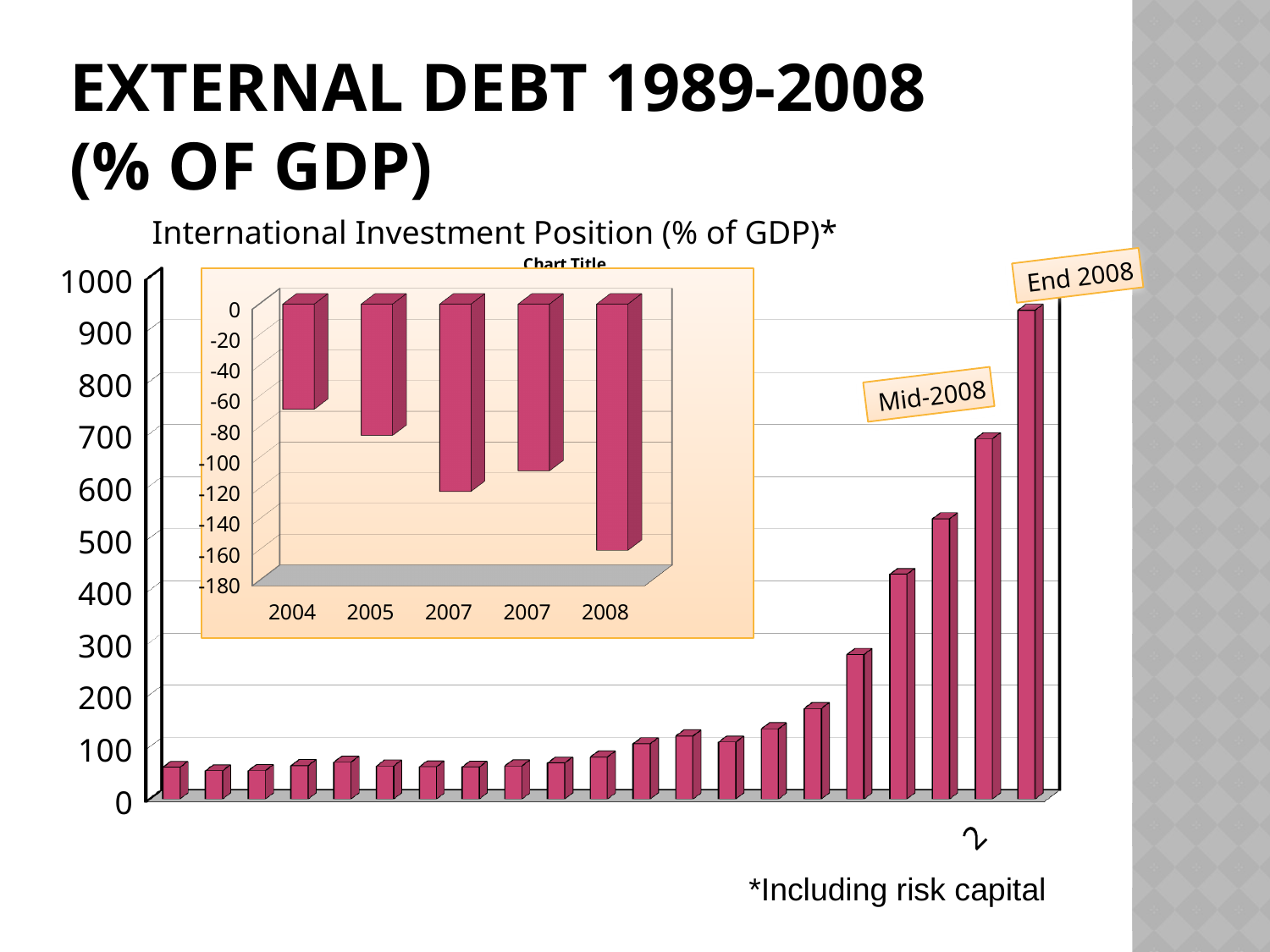
In the inset chart 'International Investment Position (% of GDP)*', is the value for 2004 greater or less than -40? less What kind of chart is the large chart on the slide? bar chart In the inset chart 'International Investment Position (% of GDP)*', which category has the lowest (most negative) value? 2008 In the inset chart 'International Investment Position (% of GDP)*', is the value for 2005 greater or less than -100? greater In the large chart, do the values generally rise or fall from left to right along the x axis? rise In the large chart, which is larger, the value for Mid-2008 or the value for End 2008? End 2008 How many bars does the inset chart 'International Investment Position (% of GDP)*' show? 5 In the large chart, is the value for Mid-2008 greater or less than 600? greater In the large chart, which labelled bar is the highest? End 2008